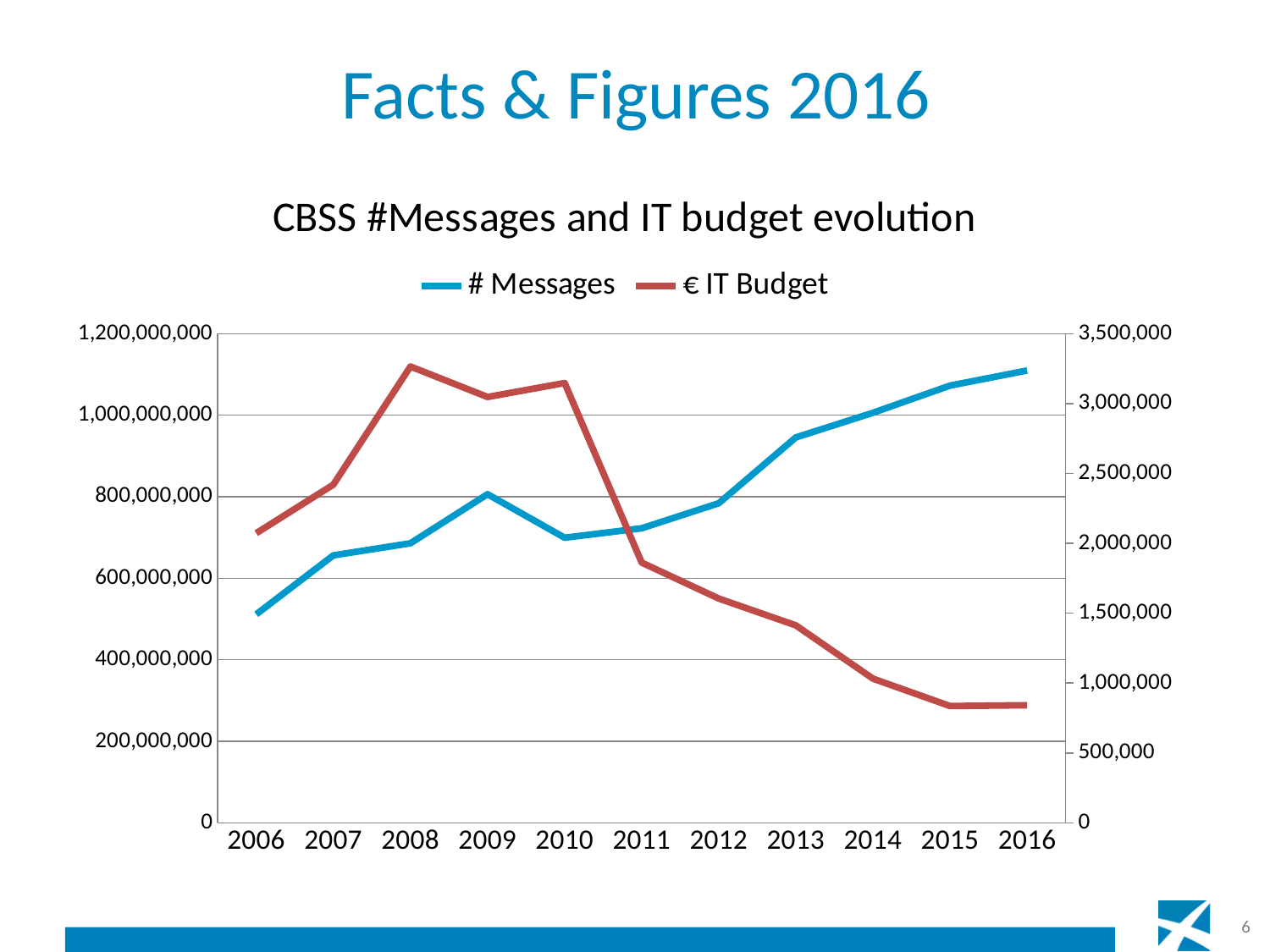
How many series does the legend list? 2 Which year has the larger # Messages value, 2009 or 2010? 2009 Is the # Messages value for 2016 greater or less than 1,000,000,000? greater In which year is the # Messages value highest? 2016 Is the € IT Budget value for 2016 greater or less than 1,000,000? less What kind of chart is shown on the slide? Line chart How many years are plotted along the x axis? 11 Which series is drawn in red? € IT Budget In which year is the # Messages value lowest? 2006 In which year is the € IT Budget value highest? 2008 Does the € IT Budget series rise or fall from 2010 to 2016? Fall What is the title of the chart? CBSS #Messages and IT budget evolution